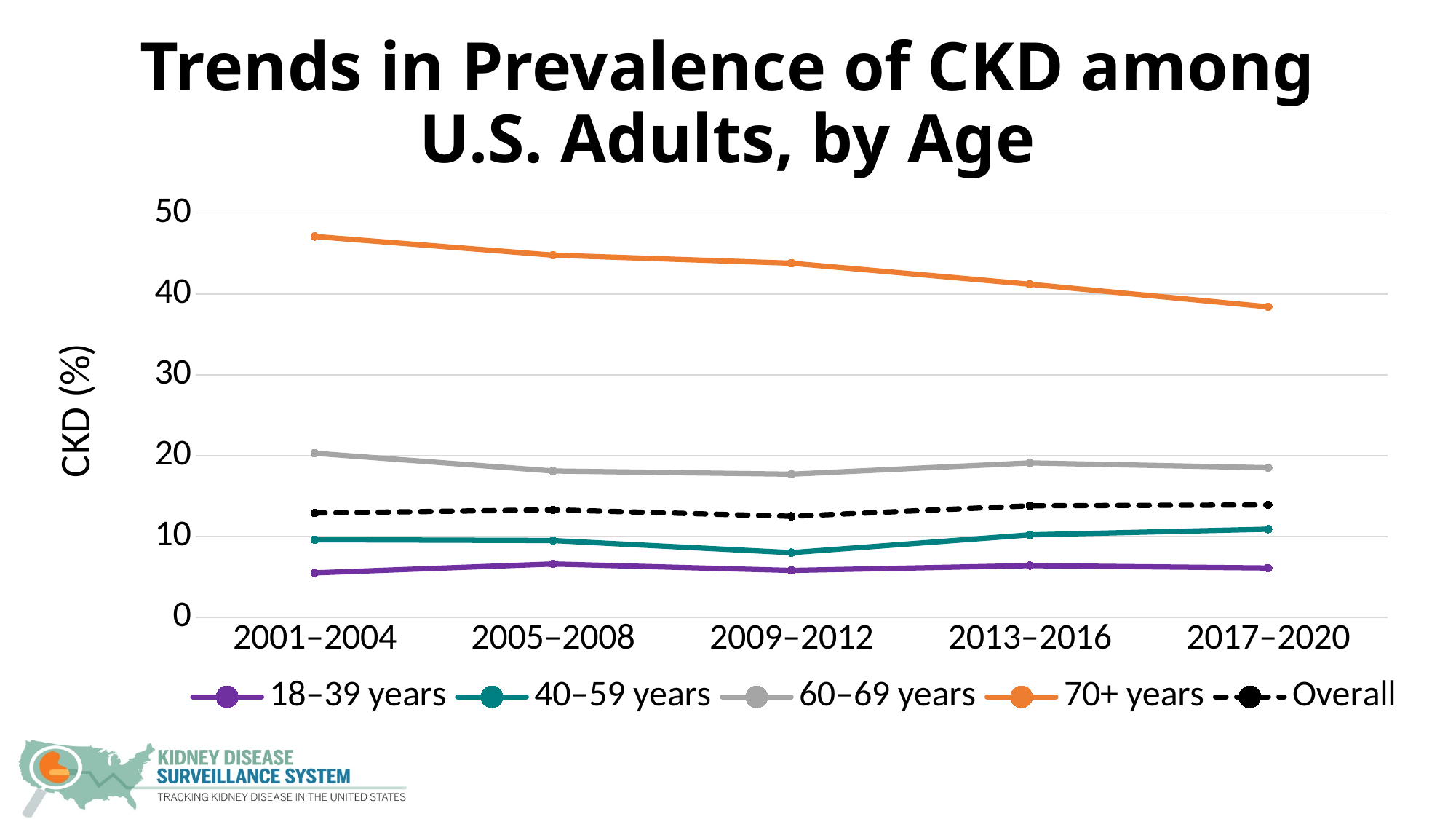
Which age group has the highest CKD prevalence in 2017–2020? 70+ years How many time periods are shown along the x axis? 5 Is the CKD prevalence for 70+ years in 2001–2004 greater or less than 40? greater In 2009–2012, which has the higher CKD prevalence: 40–59 years or 18–39 years? 40–59 years Which series is drawn with a dashed line? Overall Which age group has the lowest CKD prevalence in 2001–2004? 18–39 years Does the CKD prevalence for the 70+ years group rise or fall from 2001–2004 to 2017–2020? fall What kind of chart is shown on the slide? line chart Is the Overall CKD prevalence in 2017–2020 greater or less than 10? greater Is the CKD prevalence for 60–69 years in 2009–2012 greater or less than 20? less How many series does the legend list? 5